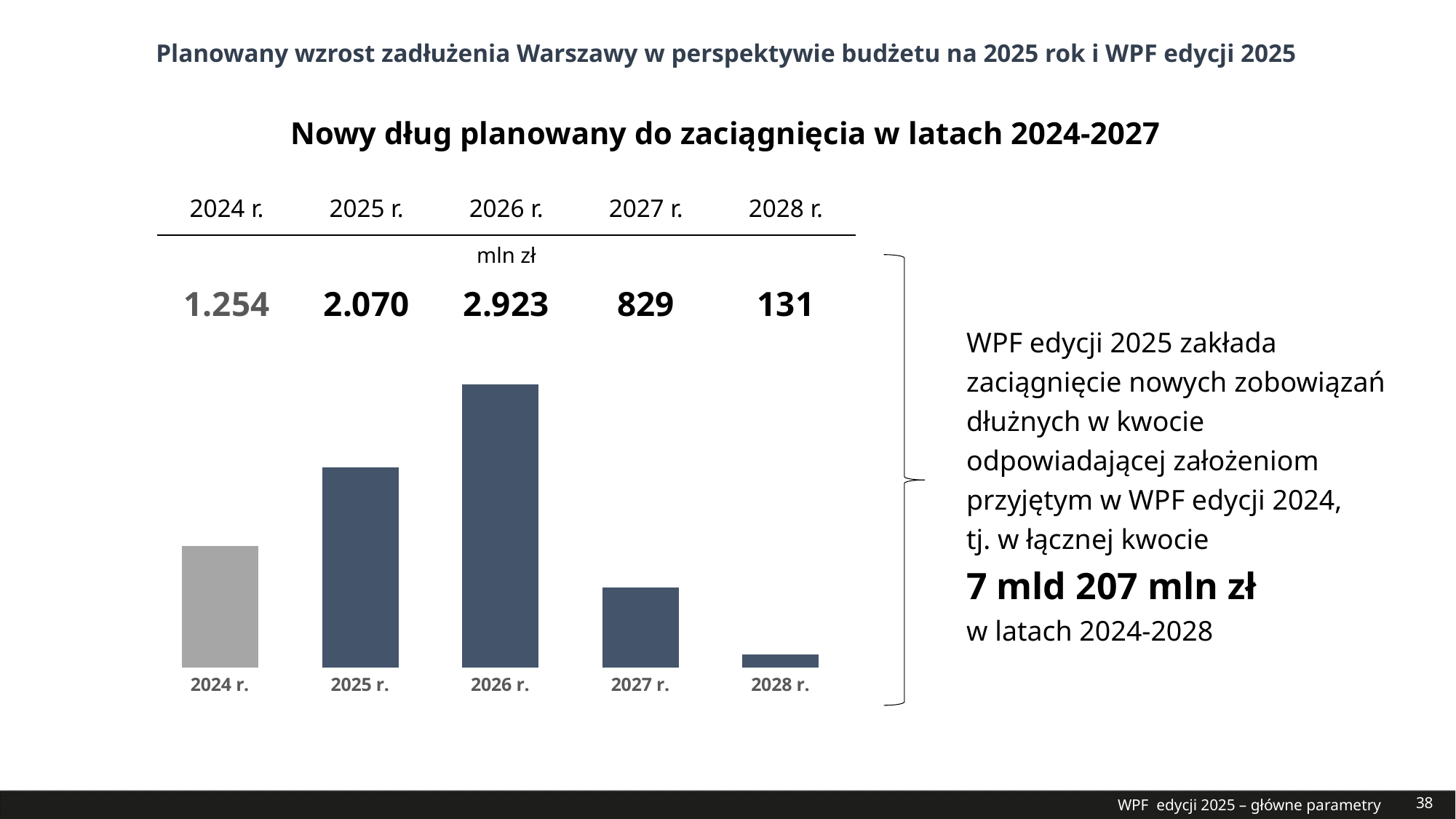
Which is larger, the value for 2025 r. or the value for 2024 r.? 2025 r. Which year has the highest value in the chart? 2026 r. What is the value for 2026 r. in the chart? 2.923 What is the value for 2027 r. in the chart? 829 How many years (bars) are shown in the chart? 5 What kind of chart is shown on the slide? Bar chart Which year has the lowest value in the chart? 2028 r. What is the value for 2028 r. in the chart? 131 What is the difference between the values for 2026 r. and 2025 r.? 853 What is the difference between the values for 2027 r. and 2028 r.? 698 What is the value for 2024 r. in the chart? 1.254 Do the values rise or fall from 2026 r. to 2028 r.? Fall